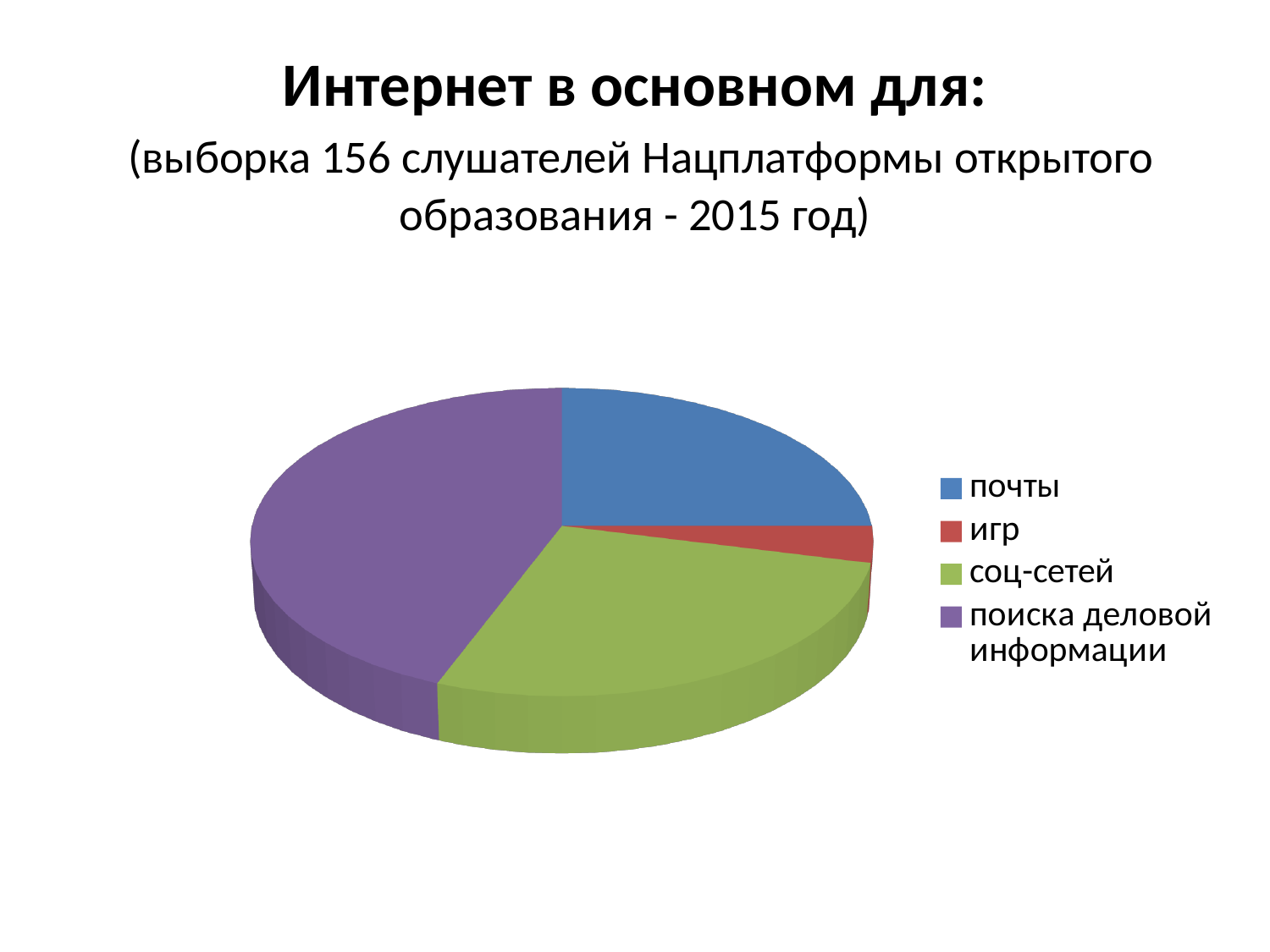
What is the title of the slide above the chart? Интернет в основном для: Which slice is larger: поиска деловой информации or почты? поиска деловой информации Which slice is larger: соц-сетей or почты? соц-сетей Which category has the largest slice of the pie? поиска деловой информации Which slice is larger: соц-сетей or игр? соц-сетей What colour is the slice for игр? red What kind of chart is shown on the slide? pie chart How many categories (slices) does the pie chart have? 4 Which category has the smallest slice of the pie? игр How many entries does the legend list? 4